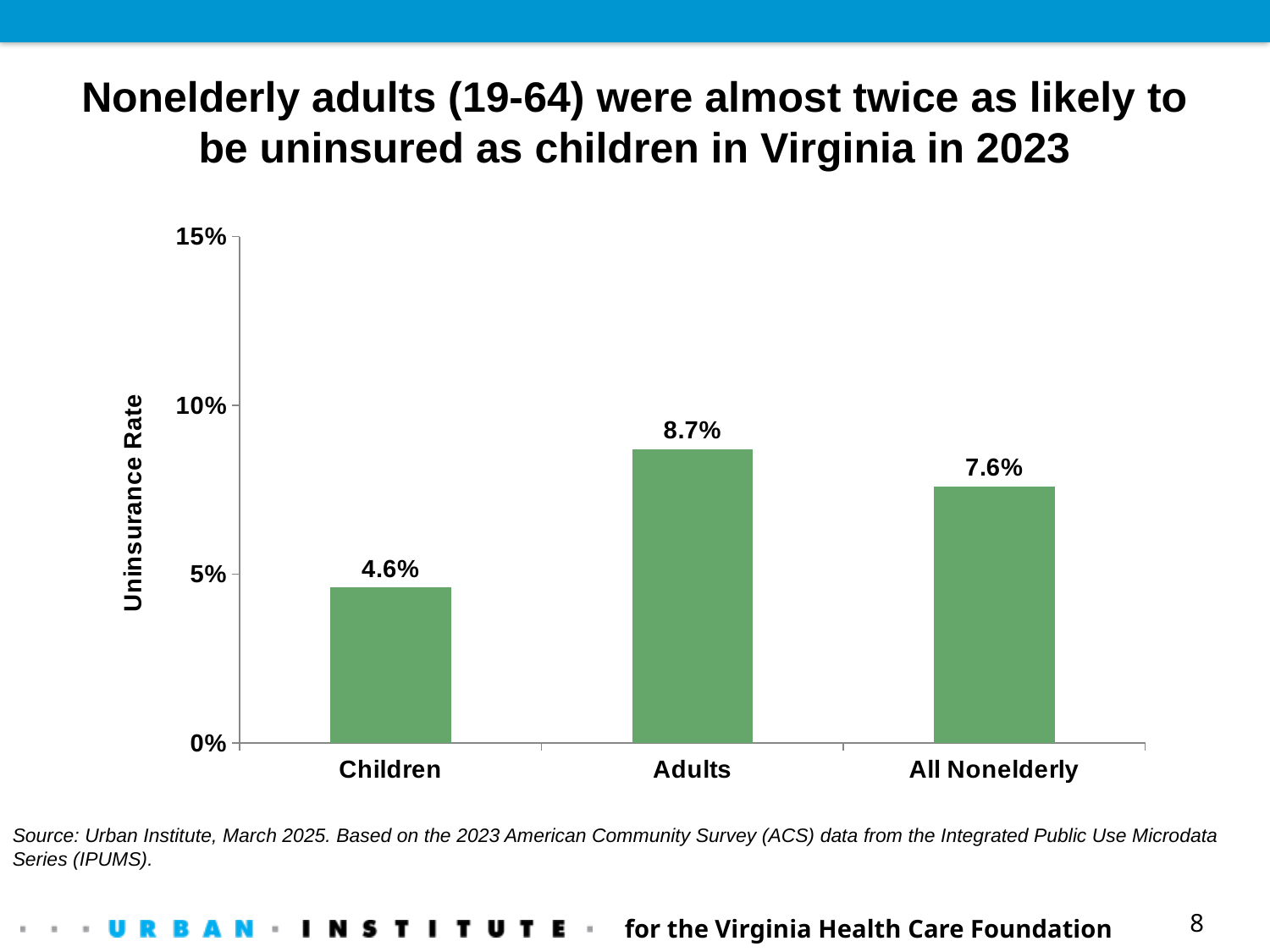
What is the uninsurance rate for Children? 4.6% What is the difference in uninsurance rate between Adults and All Nonelderly? 1.1% What is the label of the vertical axis? Uninsurance Rate What is the uninsurance rate for All Nonelderly? 7.6% Which category has the highest uninsurance rate? Adults Which category has the lowest uninsurance rate? Children What kind of chart is shown on the slide? bar chart Is the uninsurance rate for Adults greater or less than 10%? less Which has a higher uninsurance rate, Children or All Nonelderly? All Nonelderly What is the uninsurance rate for Adults? 8.7% What is the difference in uninsurance rate between Adults and Children? 4.1% How many categories are shown on the chart? 3